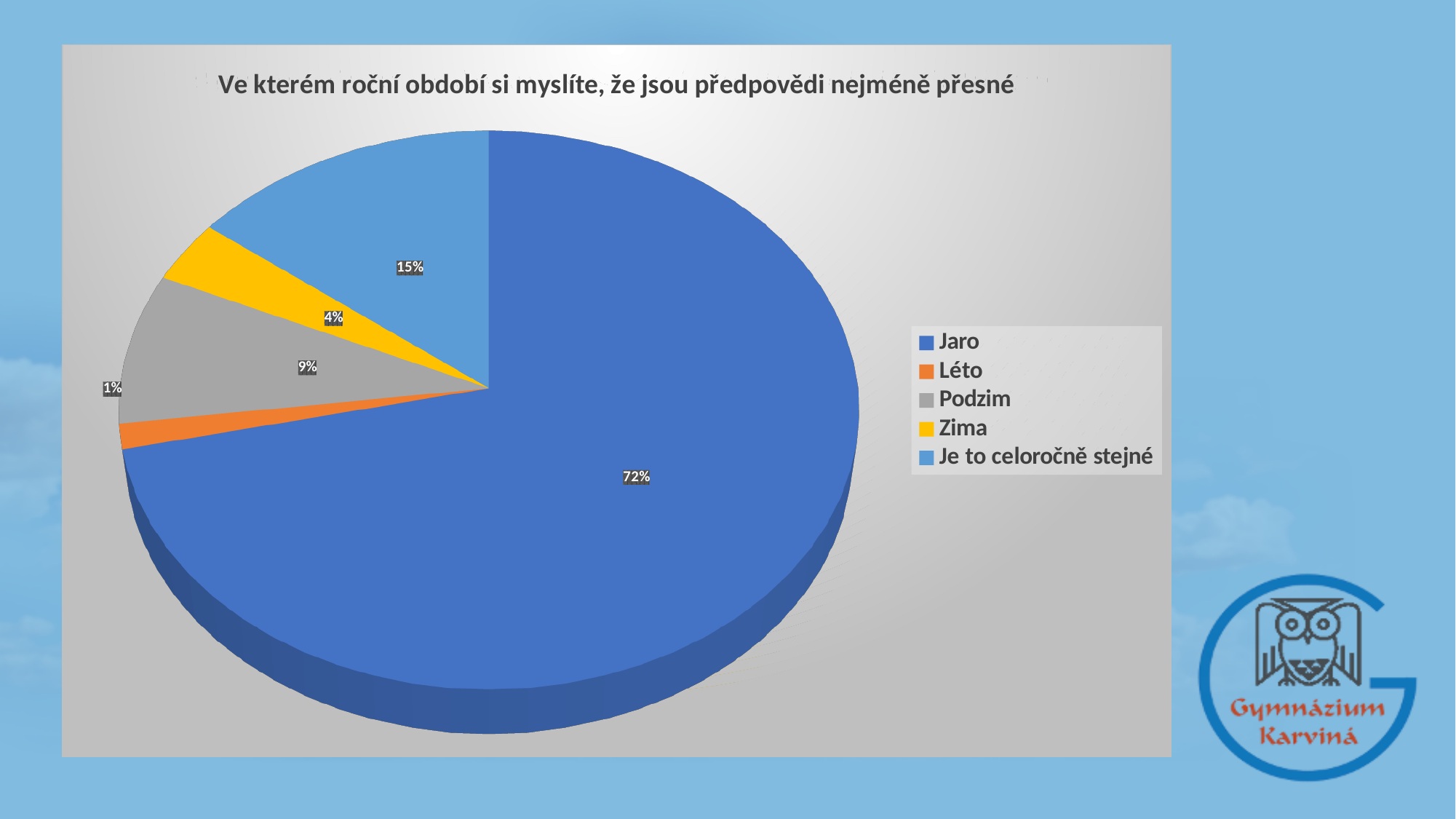
Which category has the largest slice of the pie? Jaro What kind of chart is shown on the slide? pie chart What percentage of the pie is the Jaro slice? 72% What percentage of the pie is the Podzim slice? 9% What percentage of the pie is the Léto slice? 1% What is the difference in percentage points between the Jaro slice and the 'Je to celoročně stejné' slice? 57 Which slice is larger, Podzim or Zima? Podzim Which category has the smallest slice of the pie? Léto How many categories does the legend list? 5 What is the title of the chart? Ve kterém roční období si myslíte, že jsou předpovědi nejméně přesné